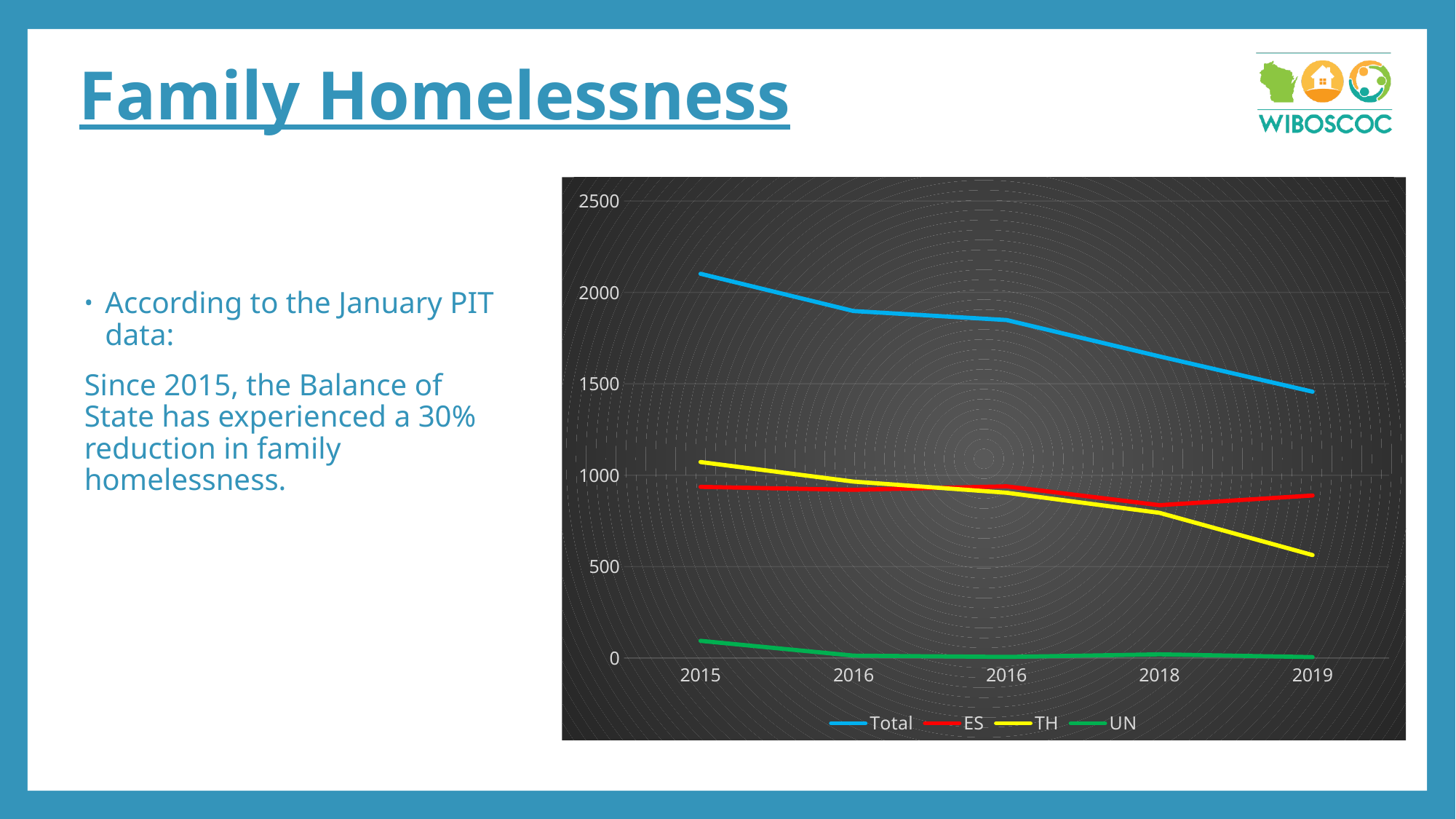
What colour is the line for the Total series? blue Is the value for UN in 2019 greater or less than 500? less Is the value for Total in 2018 greater or less than 1500? greater Is the value for Total in 2015 greater or less than 2000? greater What kind of chart is shown on the slide? line chart How many series does the chart legend list? 4 Does the TH series rise or fall from 2015 to 2019? fall In 2019, which series has the larger value, ES or TH? ES Does the Total series rise or fall from 2015 to 2019? fall Which series has the lowest values across all years? UN How many points are plotted along the x axis for each series? 5